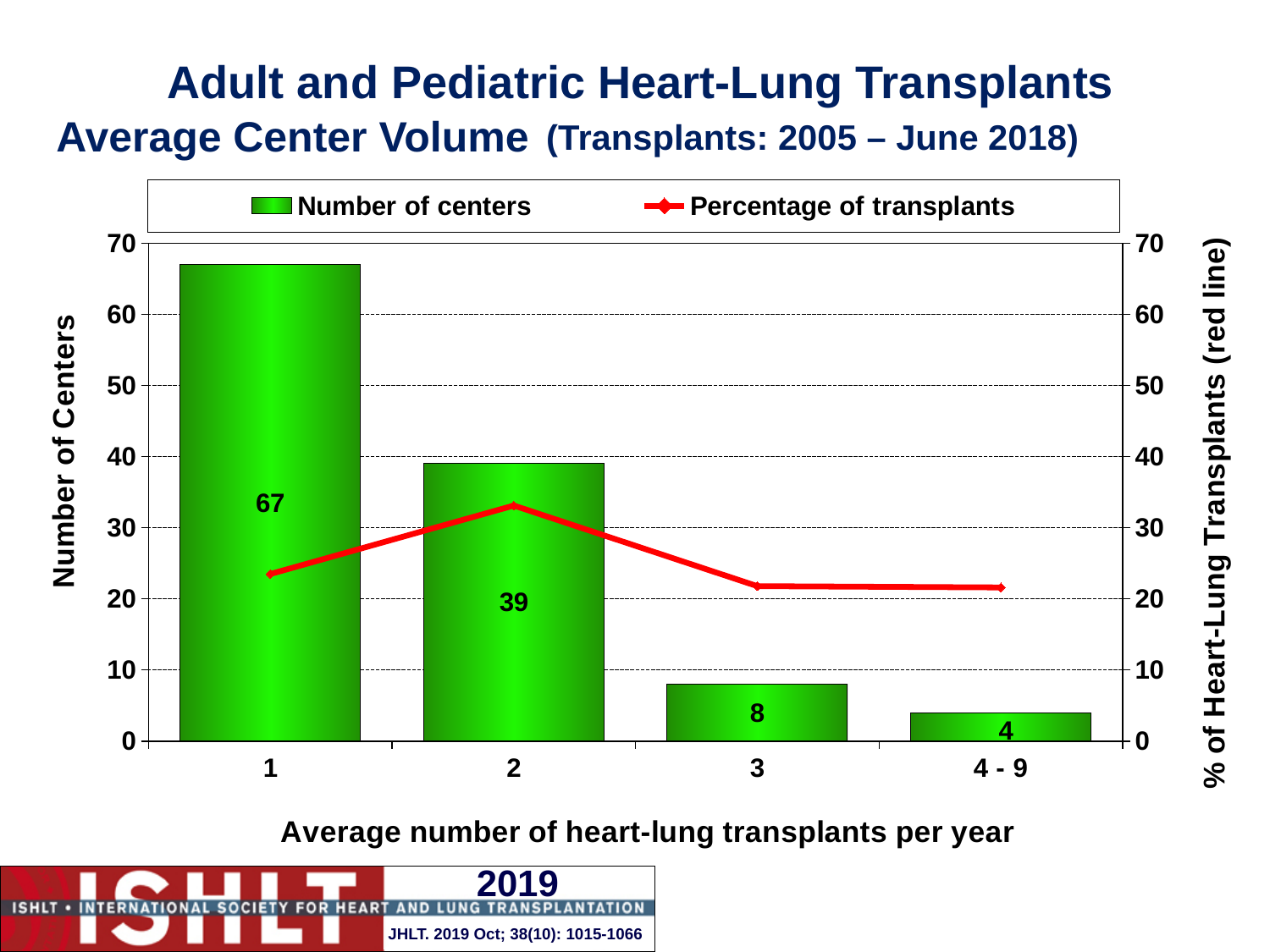
How many series does the legend list? 2 Do the number of centers rise or fall as the average number of transplants per year increases along the x axis? fall Which average-volume category has the highest number of centers? 1 How many centers have an average of 2 heart-lung transplants per year? 39 How many centers have an average of 1 heart-lung transplant per year? 67 How many centers have an average of 4 - 9 heart-lung transplants per year? 4 Is the percentage of transplants for the 1 transplant-per-year category greater or less than 30? less How many centers have an average of 3 heart-lung transplants per year? 8 Which average-volume category has the lowest number of centers? 4 - 9 What is the difference in the number of centers between the 1 and 2 transplants-per-year categories? 28 Is the percentage of transplants for the 2 transplants-per-year category greater or less than 30? greater Which category has more centers: 3 or 4 - 9 transplants per year? 3